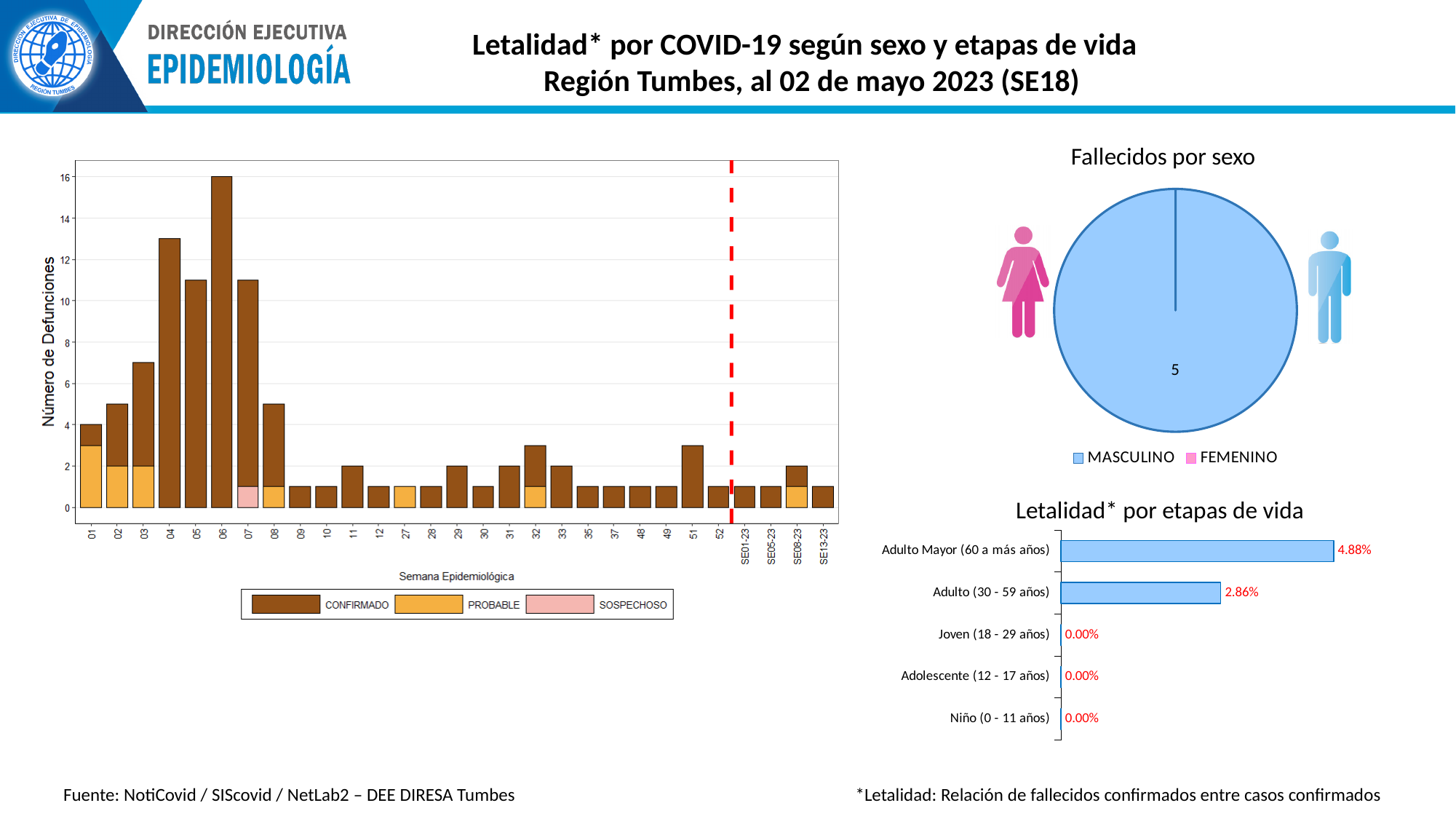
In the 'Fallecidos por sexo' chart, what value is shown for MASCULINO? 5 How many series does the legend of the bar chart on the left (Número de Defunciones) list? 3 What kind of chart is 'Letalidad* por etapas de vida'? Bar chart What kind of chart is 'Fallecidos por sexo'? Pie chart In the 'Letalidad* por etapas de vida' chart, what is the value for Adulto Mayor (60 a más años)? 4.88% In the 'Letalidad* por etapas de vida' chart, which age group has the highest value? Adulto Mayor (60 a más años) In the bar chart on the left (Número de Defunciones by Semana Epidemiológica), is the value for week 04 greater or less than 12? greater How many age groups are shown in the 'Letalidad* por etapas de vida' chart? 5 In the 'Letalidad* por etapas de vida' chart, what is the difference between Adulto Mayor (60 a más años) and Adulto (30 - 59 años)? 2.02% In the 'Letalidad* por etapas de vida' chart, what is the value for Adulto (30 - 59 años)? 2.86% How many entries does the legend of the 'Fallecidos por sexo' chart list? 2 In the bar chart on the left (Número de Defunciones by Semana Epidemiológica), which week has the highest number of deaths? 06